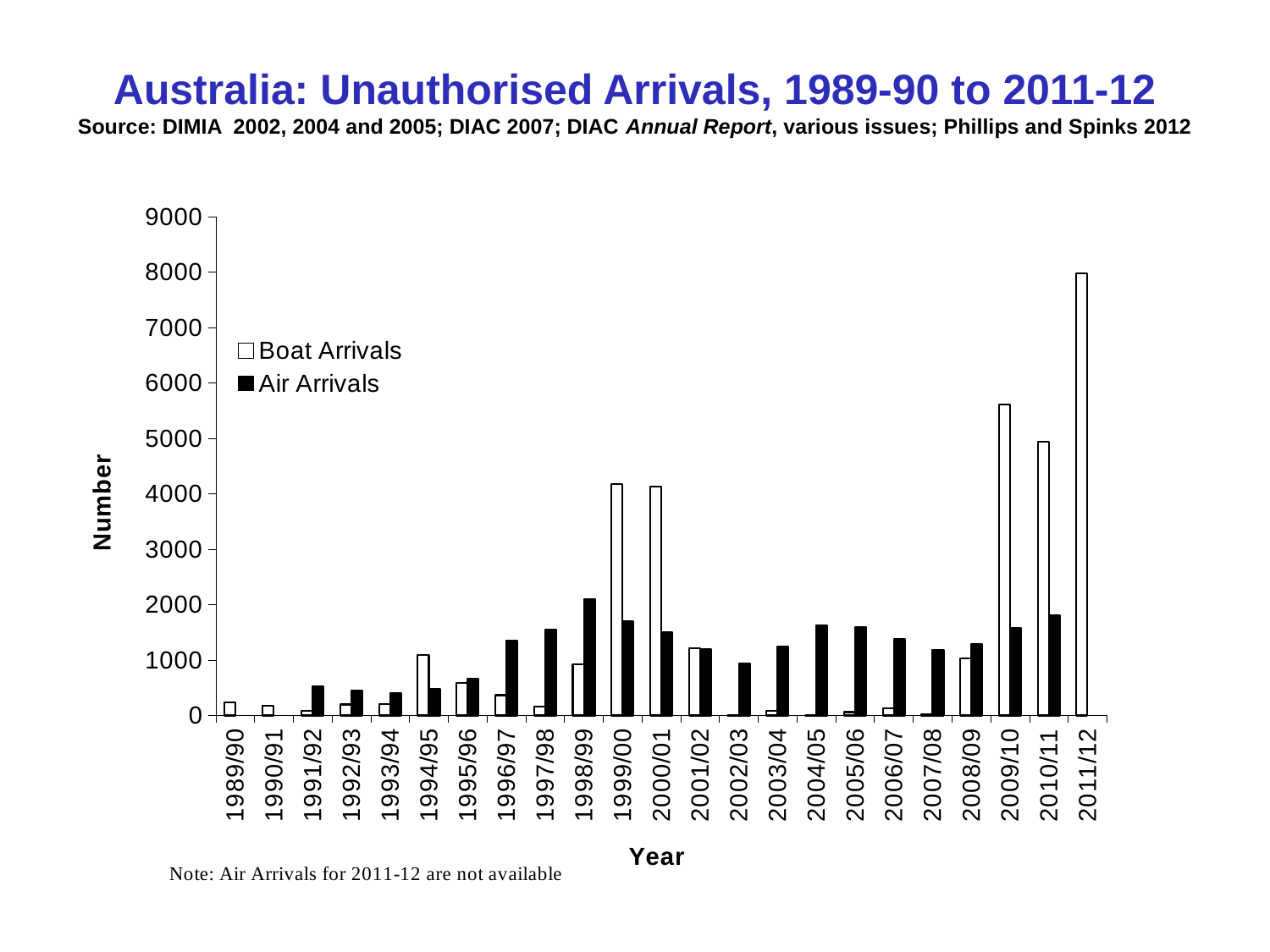
Which is larger, Boat Arrivals in 2009/10 or Boat Arrivals in 2010/11? Boat Arrivals in 2009/10 How many series does the legend list? 2 How many years are shown on the x axis? 23 Do Air Arrivals rise or fall from 1993/94 to 1998/99? Rise Is the value for Boat Arrivals in 2009/10 greater or less than 5000? greater Which series is shown with black bars? Air Arrivals What kind of chart is shown on the slide? Bar chart In which year are Boat Arrivals highest? 2011/12 Is the value for Air Arrivals in 1996/97 greater or less than 1000? greater In which year are Air Arrivals highest? 1998/99 Is the value for Boat Arrivals in 2011/12 greater or less than 7000? greater Which is larger in 2010/11, Boat Arrivals or Air Arrivals? Boat Arrivals